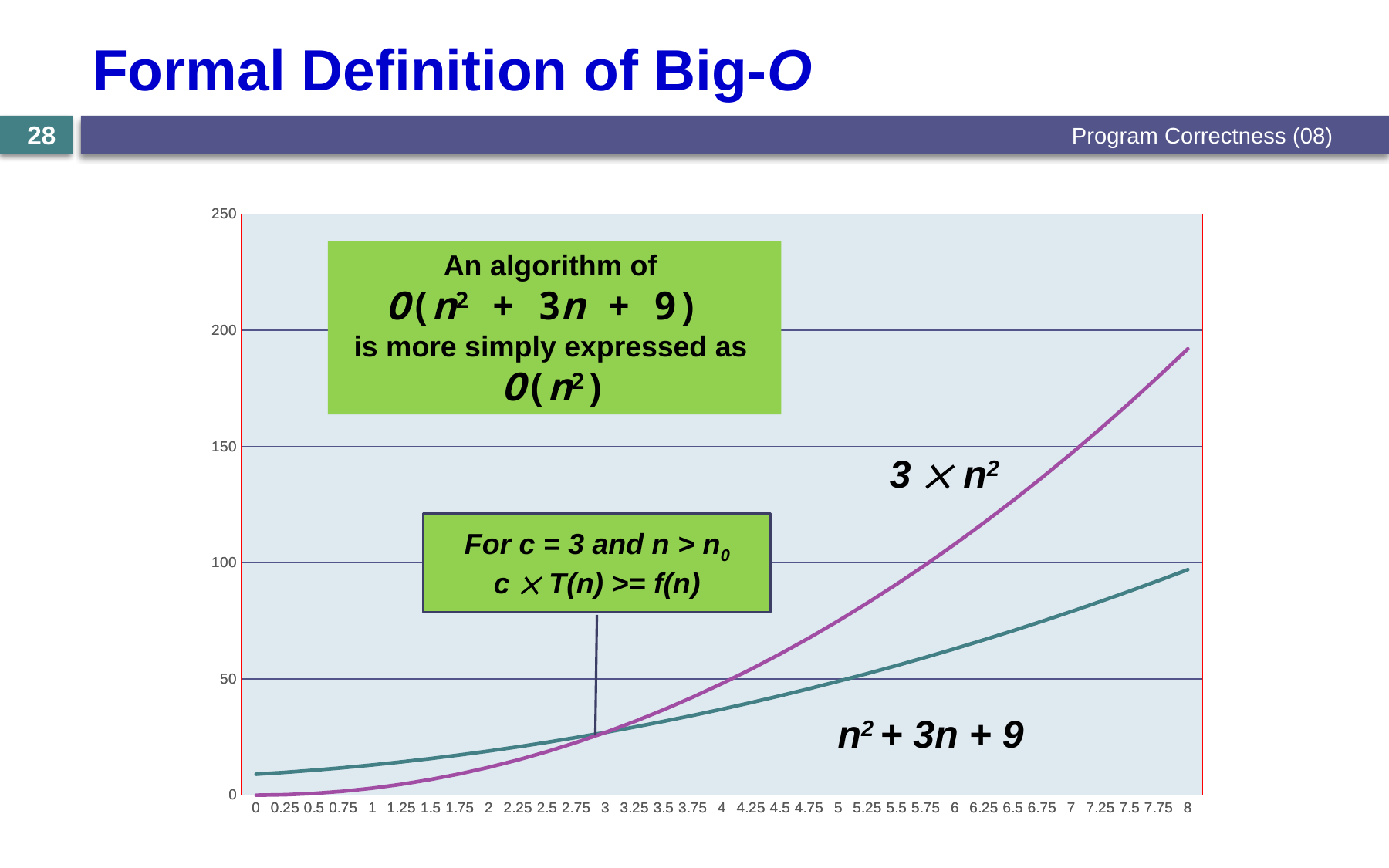
What is the highest value shown on the y axis? 250 Does the n² + 3n + 9 curve rise or fall as n increases along the x axis? rise Is the value of n² + 3n + 9 at n = 2 greater or less than 50? less Is the value of 3 × n² at n = 8 greater or less than 150? greater Which two functions are labelled on the chart? 3 × n² and n² + 3n + 9 Does the 3 × n² curve rise or fall as n increases along the x axis? rise What is the largest value of n shown on the x axis? 8 Is the value of 3 × n² at n = 6 greater or less than 100? greater At n = 1, which curve is higher: 3 × n² or n² + 3n + 9? n² + 3n + 9 At n = 8, which curve is higher: 3 × n² or n² + 3n + 9? 3 × n² What kind of chart is shown on the slide? line chart How many curves are plotted on the chart? 2